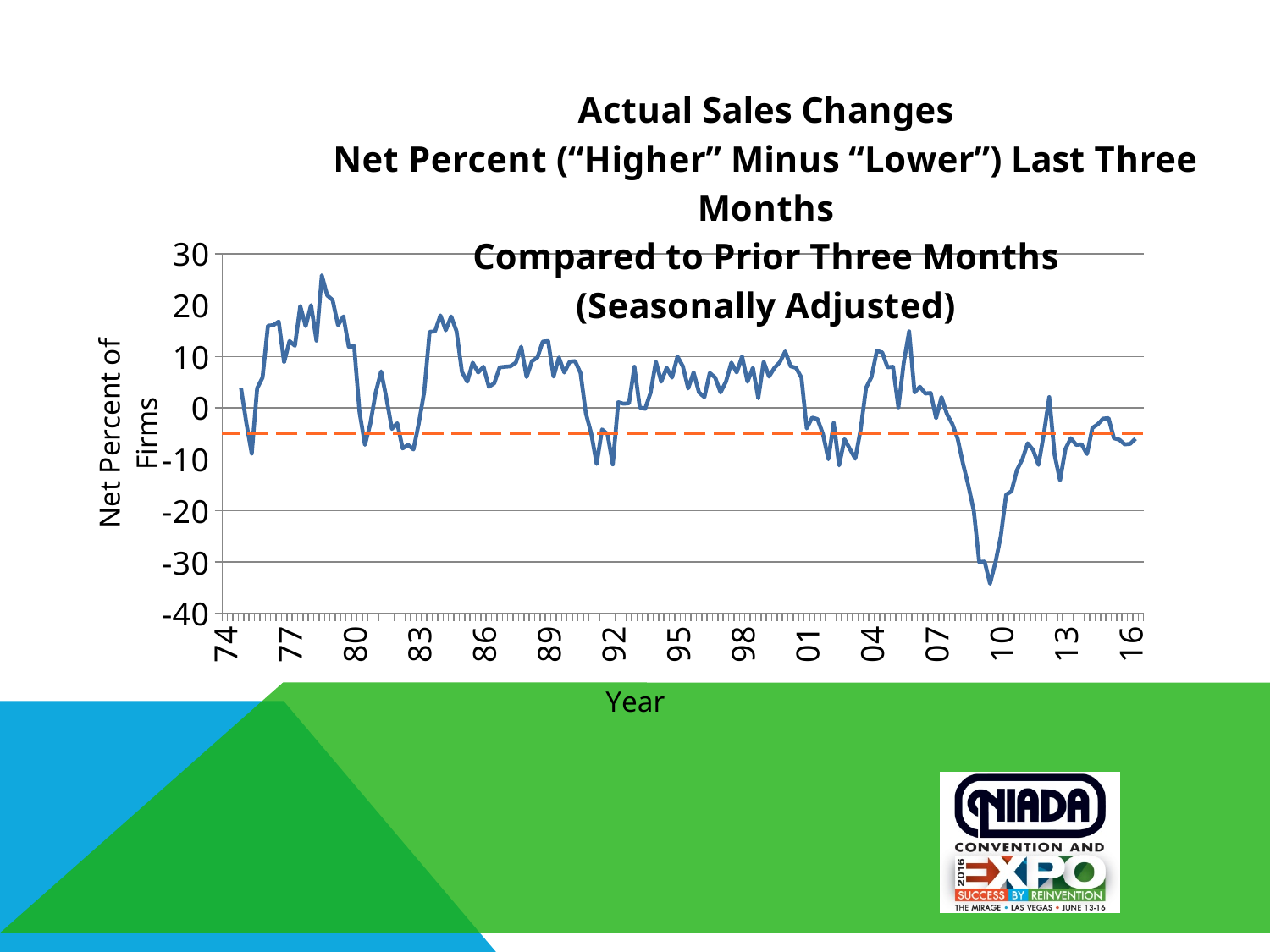
Does the line rise or fall between 2009 and 2012? rise Is the value at the end of the line, around 2016, greater or less than 0? less Around which year does the line reach its highest value? 78 What is the label of the horizontal axis? Year Around which year does the line reach its lowest value? 09 Is the value of the line around 1984 greater or less than 10? greater Is the lowest value of the line, around 2009, greater or less than -30? less What is the label of the vertical axis? Net Percent of Firms Which is larger, the value of the line around 1978 or the value around 2009? 1978 What kind of chart is shown on the slide? line chart Does the line rise or fall between 2007 and 2009? fall